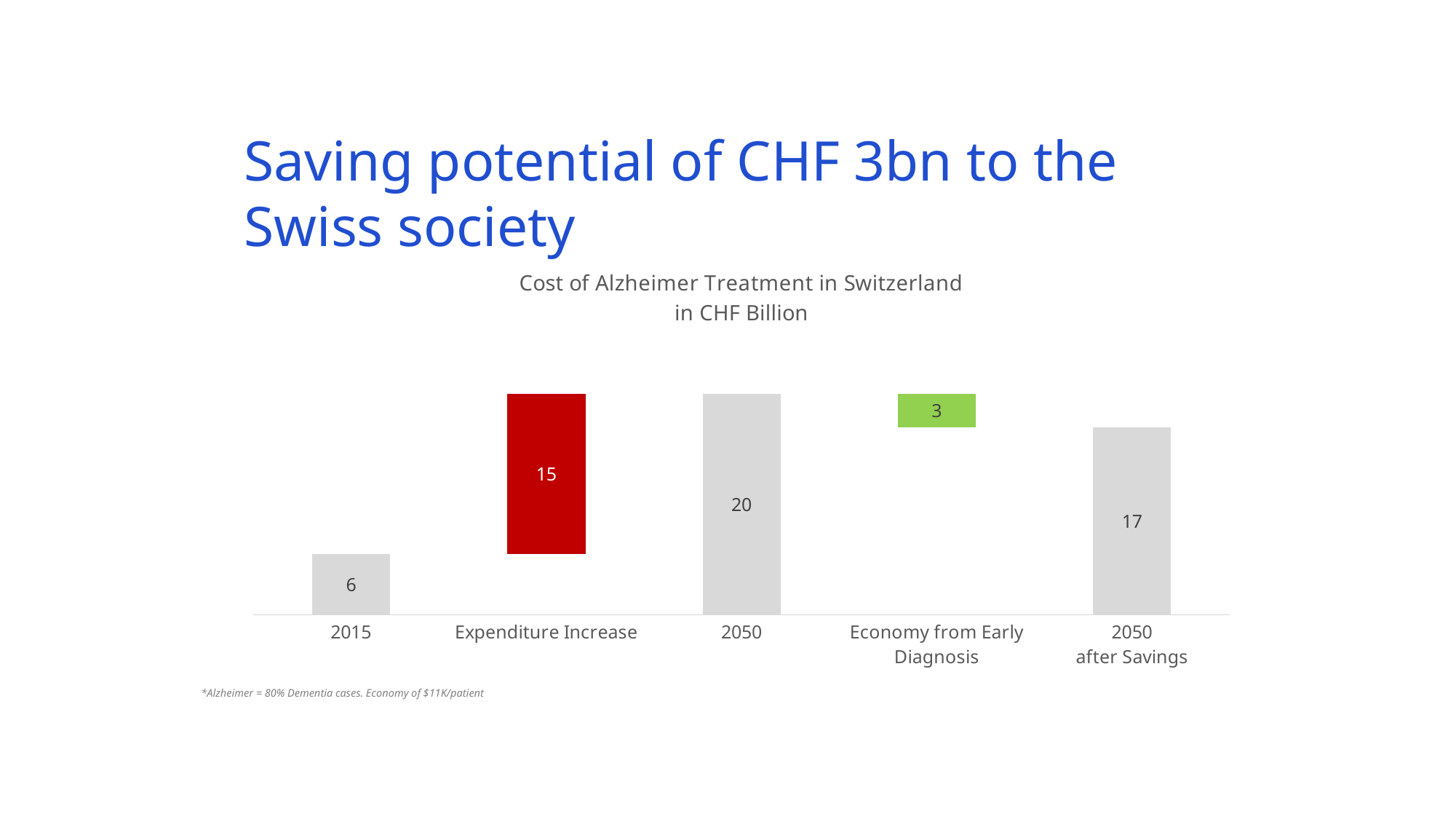
What is the value for Expenditure Increase? 15 What kind of chart is shown? Bar chart How many categories are shown on the x axis? 5 What is the value for 2050 after Savings? 17 What is the value for 2015? 6 What is the value for 2050? 20 Which category has the lowest value? Economy from Early Diagnosis Which category has the highest value? 2050 What is the value for Economy from Early Diagnosis? 3 Which is larger, the value for Expenditure Increase or the value for 2050 after Savings? 2050 after Savings What is the title of the chart? Cost of Alzheimer Treatment in Switzerland in CHF Billion What is the difference between the values for 2050 and 2050 after Savings? 3